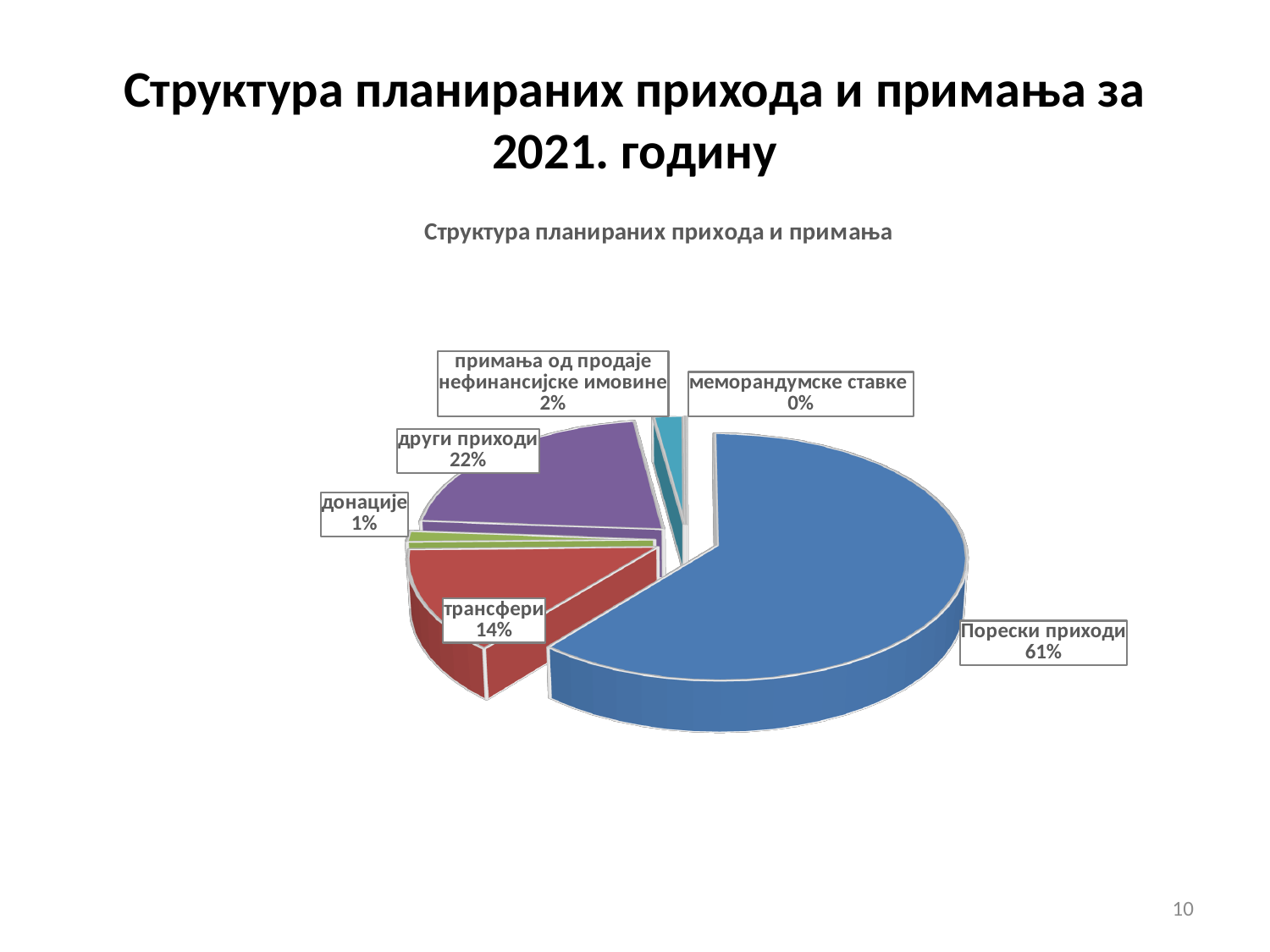
What share of the pie is labelled for примања од продаје нефинансијске имовине? 2% How many categories are shown in the pie chart? 6 What share of the pie is labelled for трансфери? 14% What type of chart is shown on the slide? Pie chart What share of the pie is labelled for донације? 1% What is the chart's title? Структура планираних прихода и примања Which category has the smallest share of the pie? меморандумске ставке What is the difference in percentage points between Порески приходи and други приходи? 39 percentage points Which category has the largest share of the pie? Порески приходи